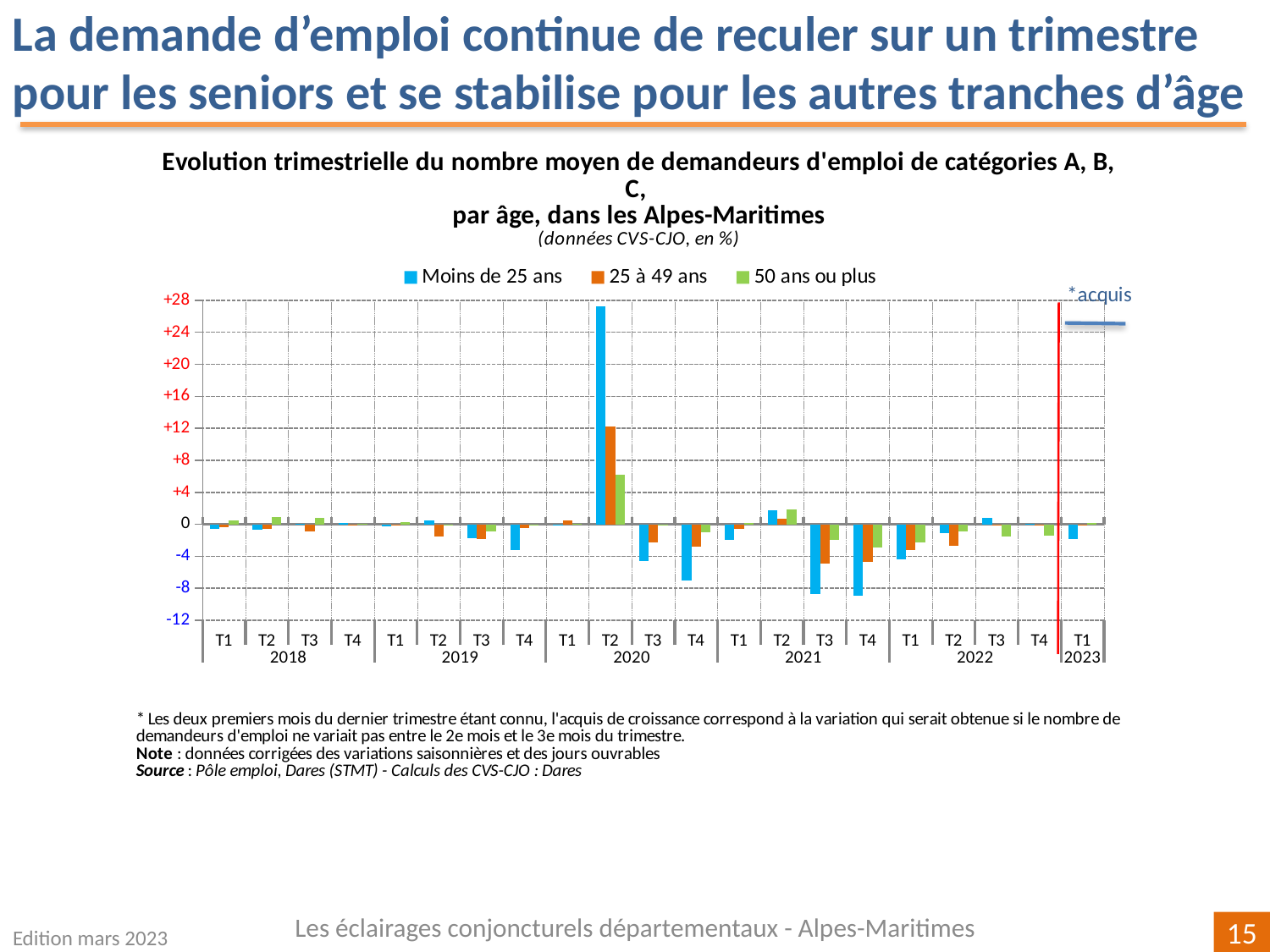
Is the value for 'Moins de 25 ans' in T4 2020 greater or less than -4? less How many quarters are plotted along the x axis, from T1 2018 to T1 2023? 21 In T3 2021, which series has the larger value: '25 à 49 ans' or '50 ans ou plus'? 50 ans ou plus In T2 2020, which series has the larger value: 'Moins de 25 ans' or '25 à 49 ans'? Moins de 25 ans Is the value for 'Moins de 25 ans' in T2 2020 greater or less than +24? greater Which series is shown in blue in the legend? Moins de 25 ans In which quarter does the 'Moins de 25 ans' series reach its highest value? T2 2020 How many series does the legend list? 3 Is the value for '25 à 49 ans' in T2 2020 greater or less than +8? greater What label is written next to the red vertical line at the right of the chart? *acquis What kind of chart is shown on the slide? bar chart